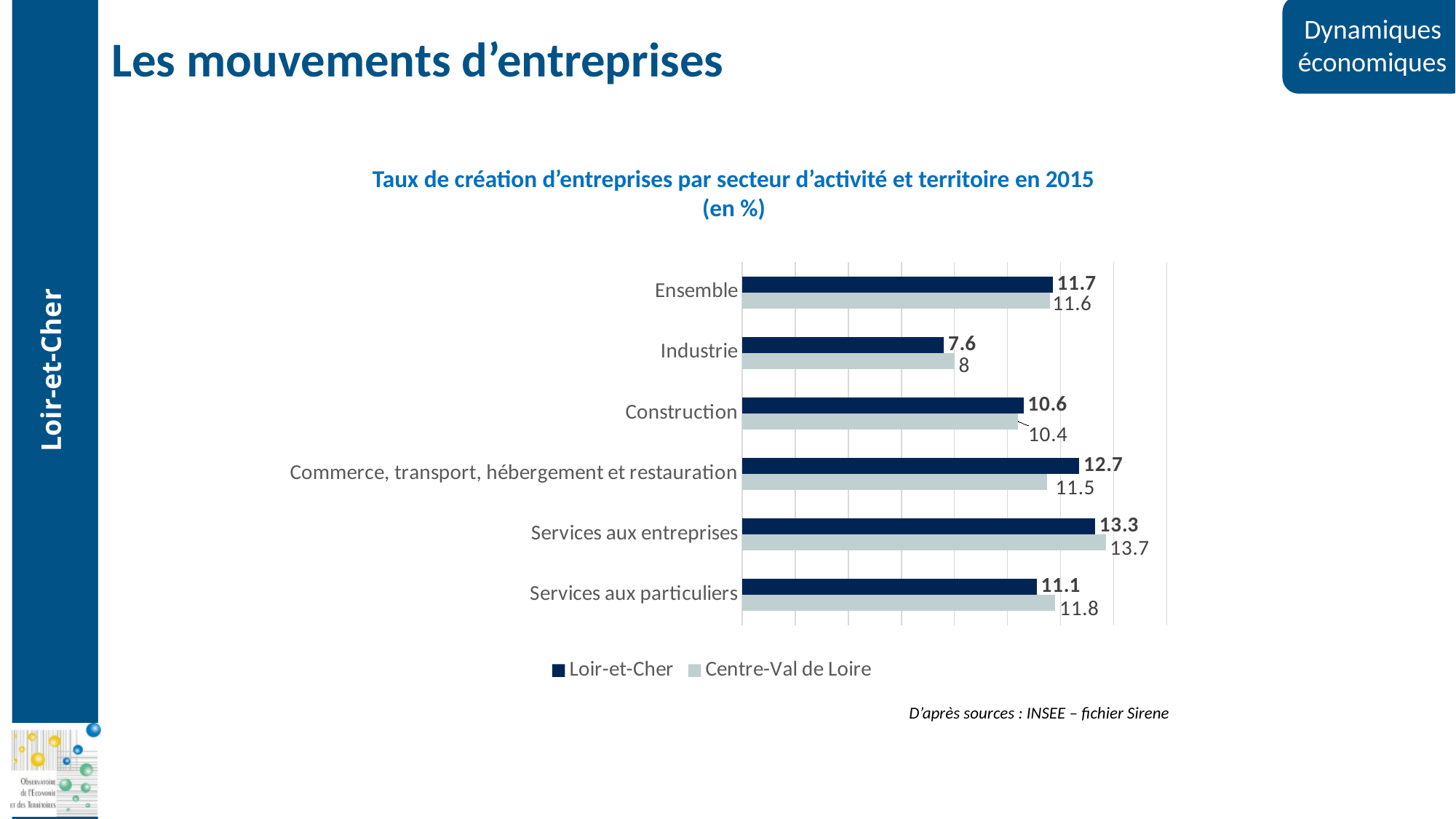
How many series does the legend list? 2 What kind of chart is shown on the slide? Bar chart What is the difference between the Loir-et-Cher and Centre-Val de Loire values for Commerce, transport, hébergement et restauration? 1.2 What is the value for Loir-et-Cher in the Industrie category? 7.6 What is the value for Centre-Val de Loire in the Services aux entreprises category? 13.7 What is the value for Loir-et-Cher in the Commerce, transport, hébergement et restauration category? 12.7 How many categories are shown on the chart? 6 Which category has the lowest value for Centre-Val de Loire? Industrie For Services aux particuliers, which series has the larger value, Loir-et-Cher or Centre-Val de Loire? Centre-Val de Loire What is the source cited below the chart? INSEE – fichier Sirene Which category has the highest value for Loir-et-Cher? Services aux entreprises What is the value for Centre-Val de Loire in the Ensemble category? 11.6